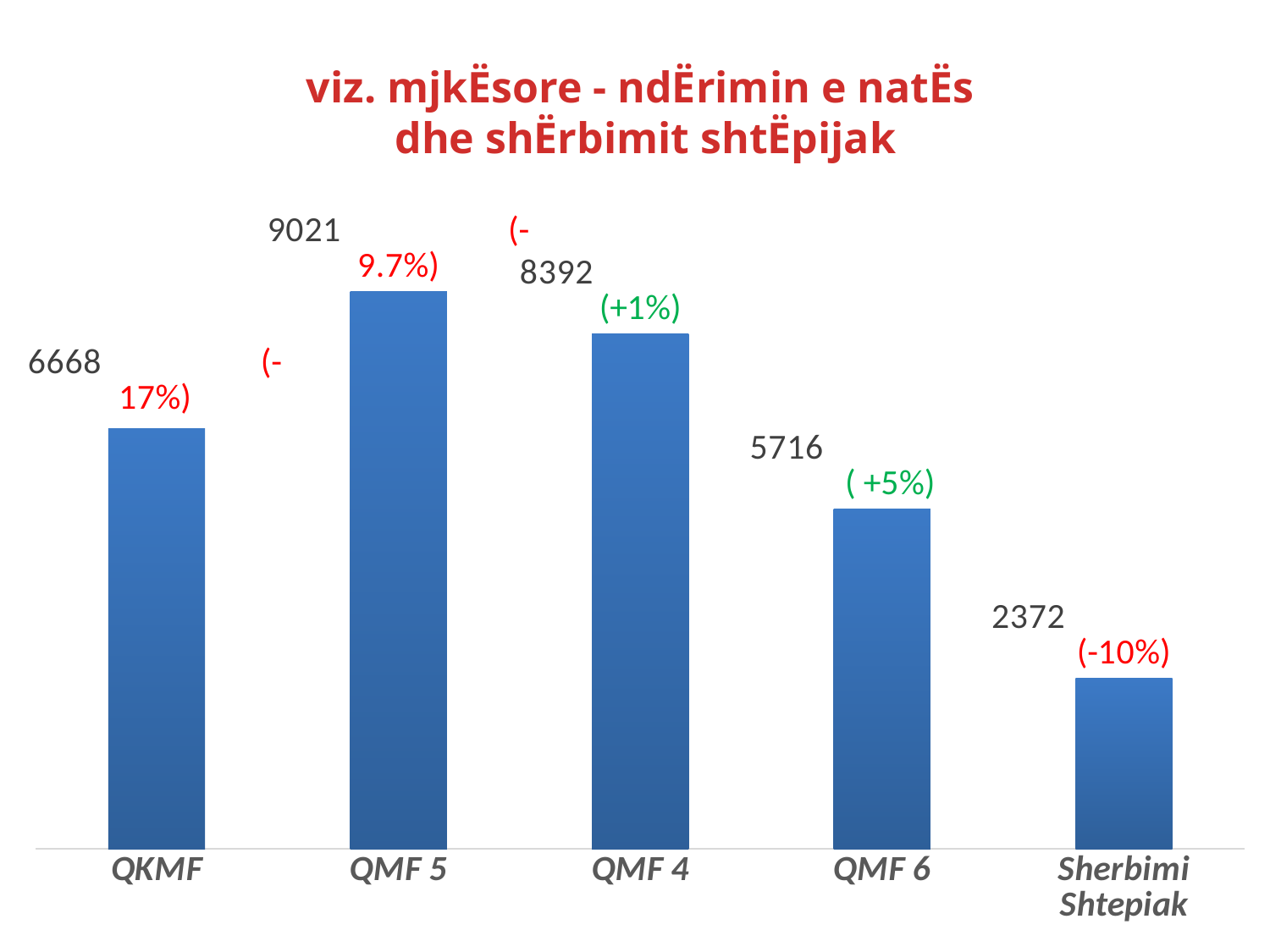
Which category has the highest value? QMF 5 How many categories are shown on the chart? 5 What is the value for Sherbimi Shtepiak? 2372 What is the difference between the values for QKMF and QMF 6? 952 What kind of chart is shown on the slide? bar chart What is the difference between the values for QMF 5 and QMF 4? 629 Which is larger, the value for QKMF or the value for QMF 6? QKMF What is the value for QMF 6? 5716 Which category has the lowest value? Sherbimi Shtepiak What is the value for QMF 5? 9021 What is the value for QMF 4? 8392 What is the value for QKMF? 6668